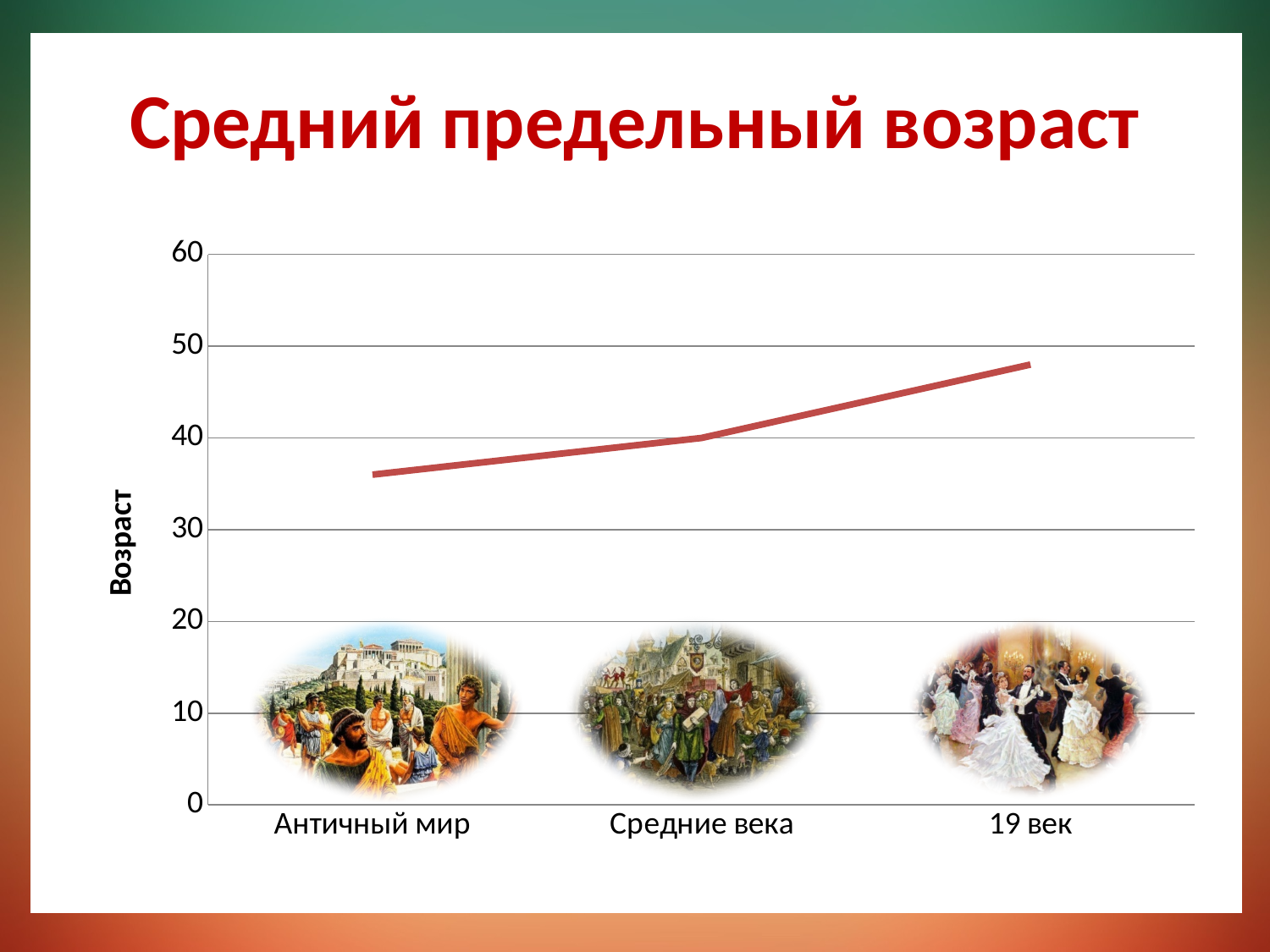
What is the label of the vertical axis? Возраст Which category has the lowest value? Античный мир Which category has the highest value? 19 век How many categories are plotted along the x axis? 3 Is the value for 19 век greater or less than 50? less What kind of chart is shown on the slide? line chart Is the value for Античный мир greater or less than 30? greater Do the values rise or fall from Античный мир to 19 век? rise Is the value for Античный мир greater or less than 40? less Which is larger, the value for 19 век or the value for Античный мир? 19 век What is the title of the chart? Средний предельный возраст